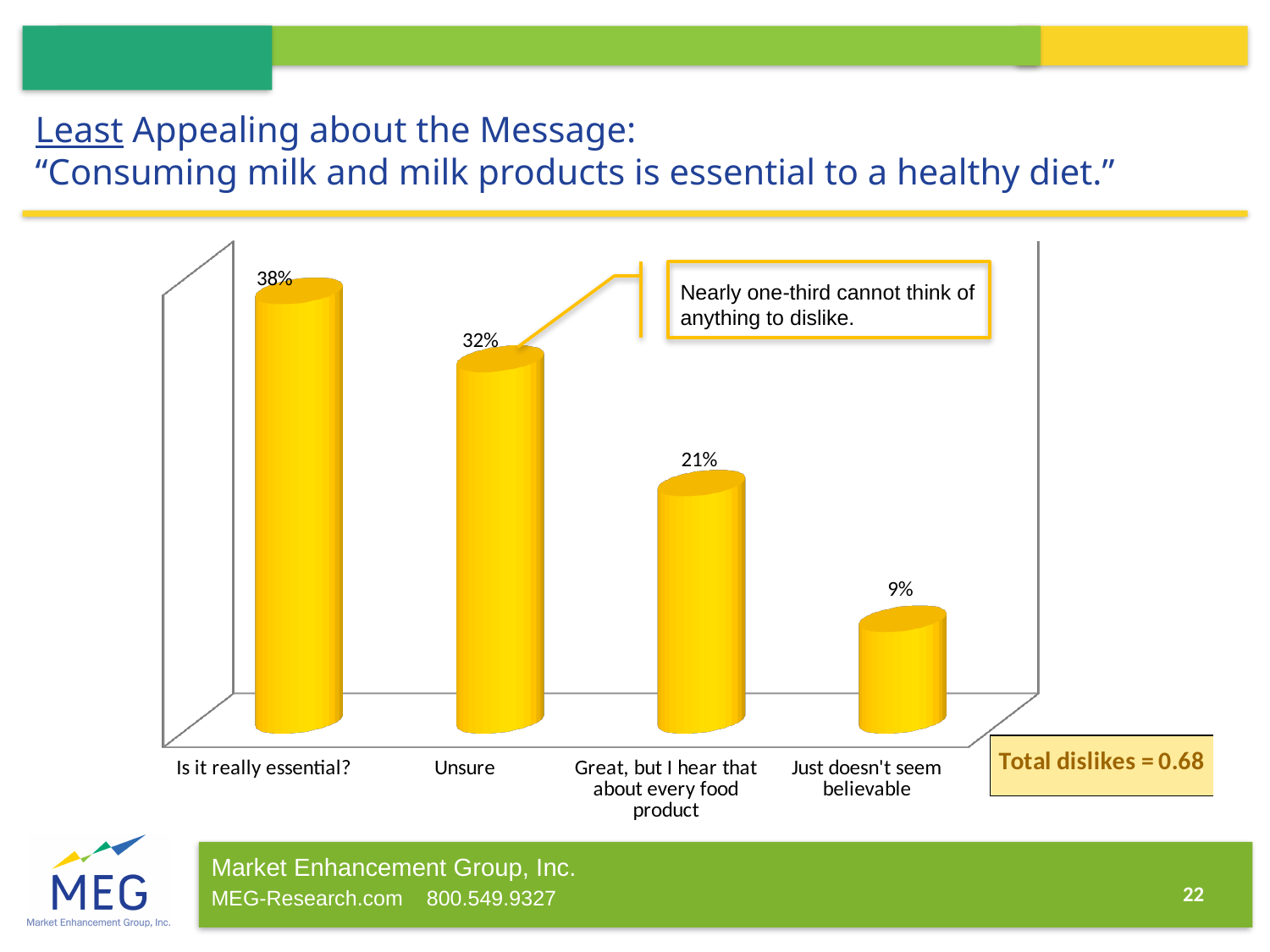
What is the difference between the values for "Is it really essential?" and "Unsure"? 6% Which category has the lowest value? Just doesn't seem believable What is the value for "Is it really essential?"? 38% What is the value for "Just doesn't seem believable"? 9% Which is larger, the value for "Unsure" or the value for "Great, but I hear that about every food product"? Unsure Which category has the highest value? Is it really essential? What is the value for "Great, but I hear that about every food product"? 21% What kind of chart is shown on the slide? Bar chart Do the values rise or fall from left to right along the x axis? Fall What is the difference between the values for "Great, but I hear that about every food product" and "Just doesn't seem believable"? 12% What is the value for "Unsure"? 32% How many categories are shown in the chart? 4